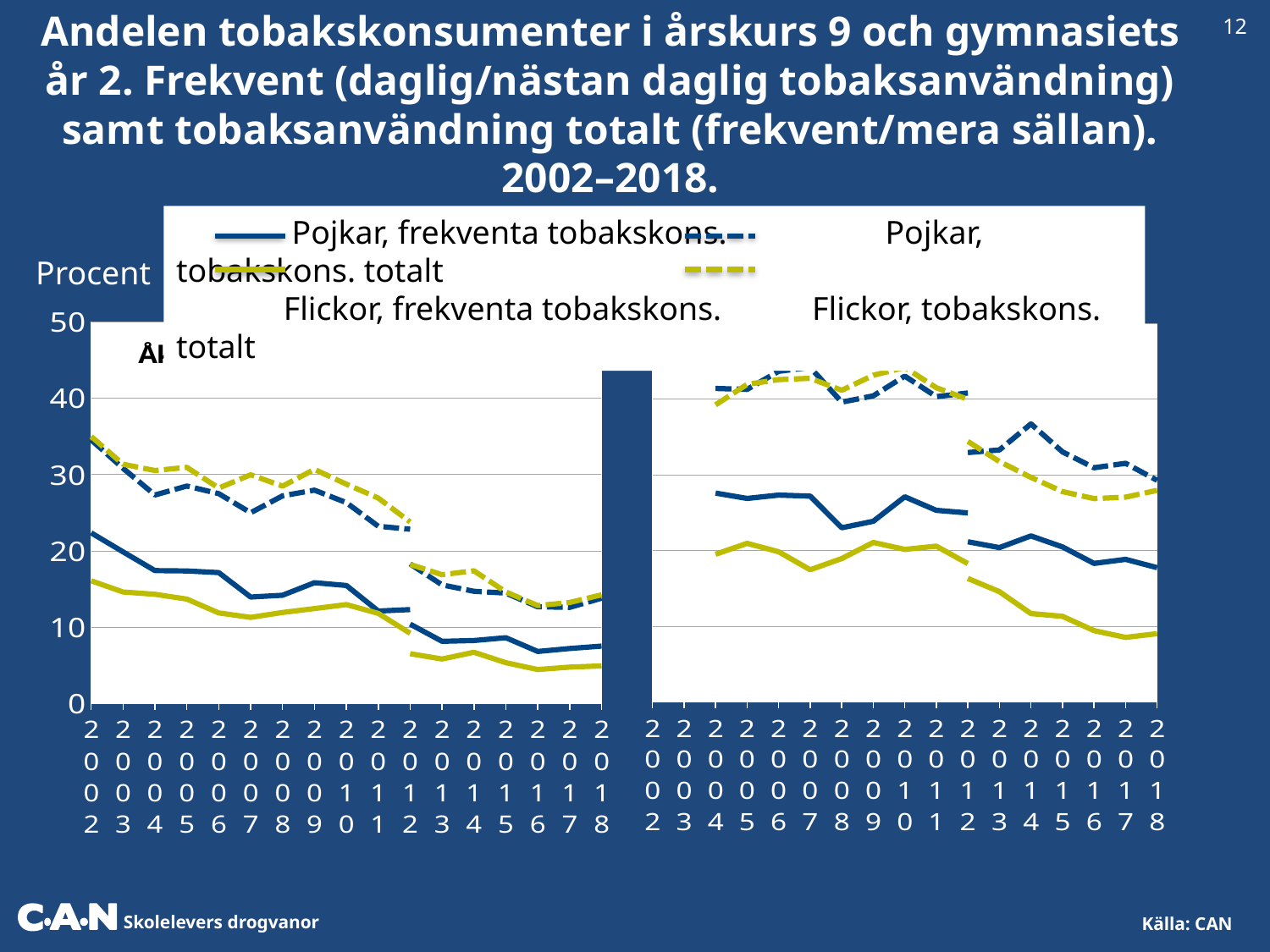
In the left chart, is the value for Pojkar, frekventa tobakskons. in 2002 greater or less than 20? greater How many series does the legend list? 4 In the right chart, does the Flickor, frekventa tobakskons. line generally rise or fall from 2002 to 2018? fall What label is shown on the y axis of the charts? Procent In the right chart, which is higher in 2018: Pojkar, frekventa tobakskons. or Flickor, frekventa tobakskons.? Pojkar, frekventa tobakskons. In the left chart, which is higher in 2002: Pojkar, frekventa tobakskons. or Flickor, frekventa tobakskons.? Pojkar, frekventa tobakskons. In the left chart, how many years are shown on the x axis? 17 What kind of chart is shown on the left side of the slide? line chart In the left chart, is the value for Flickor, frekventa tobakskons. in 2018 greater or less than 10? less In the right chart, is the value for Pojkar, tobakskons. totalt in 2018 greater or less than 40? less In the left chart, does the Pojkar, frekventa tobakskons. line generally rise or fall from 2002 to 2018? fall